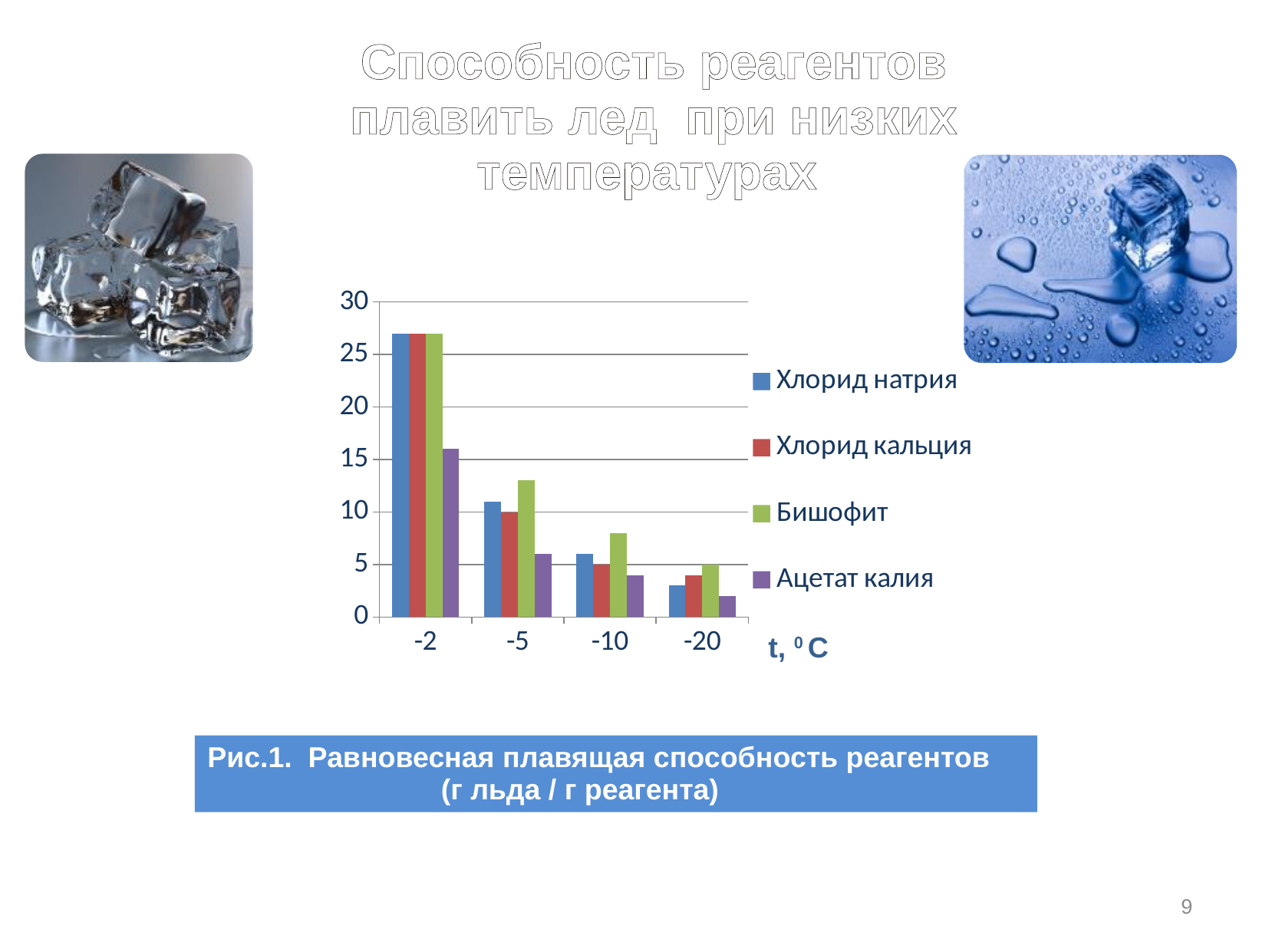
Which series has the lowest value at -20? Ацетат калия What kind of chart is shown on the slide? bar chart Which series has the lowest value at -2? Ацетат калия How many series does the legend list? 4 Is the value for Ацетат калия at -2 greater or less than 20? less Which series has the highest value at -5? Бишофит Is the value for Хлорид натрия at -2 greater or less than 25? greater At -5, which is larger: Бишофит or Хлорид кальция? Бишофит Do the values for Хлорид натрия rise or fall as the temperature goes from -2 to -20? fall How many temperature categories are shown on the x axis? 4 Is the value for Хлорид натрия at -20 greater or less than 5? less